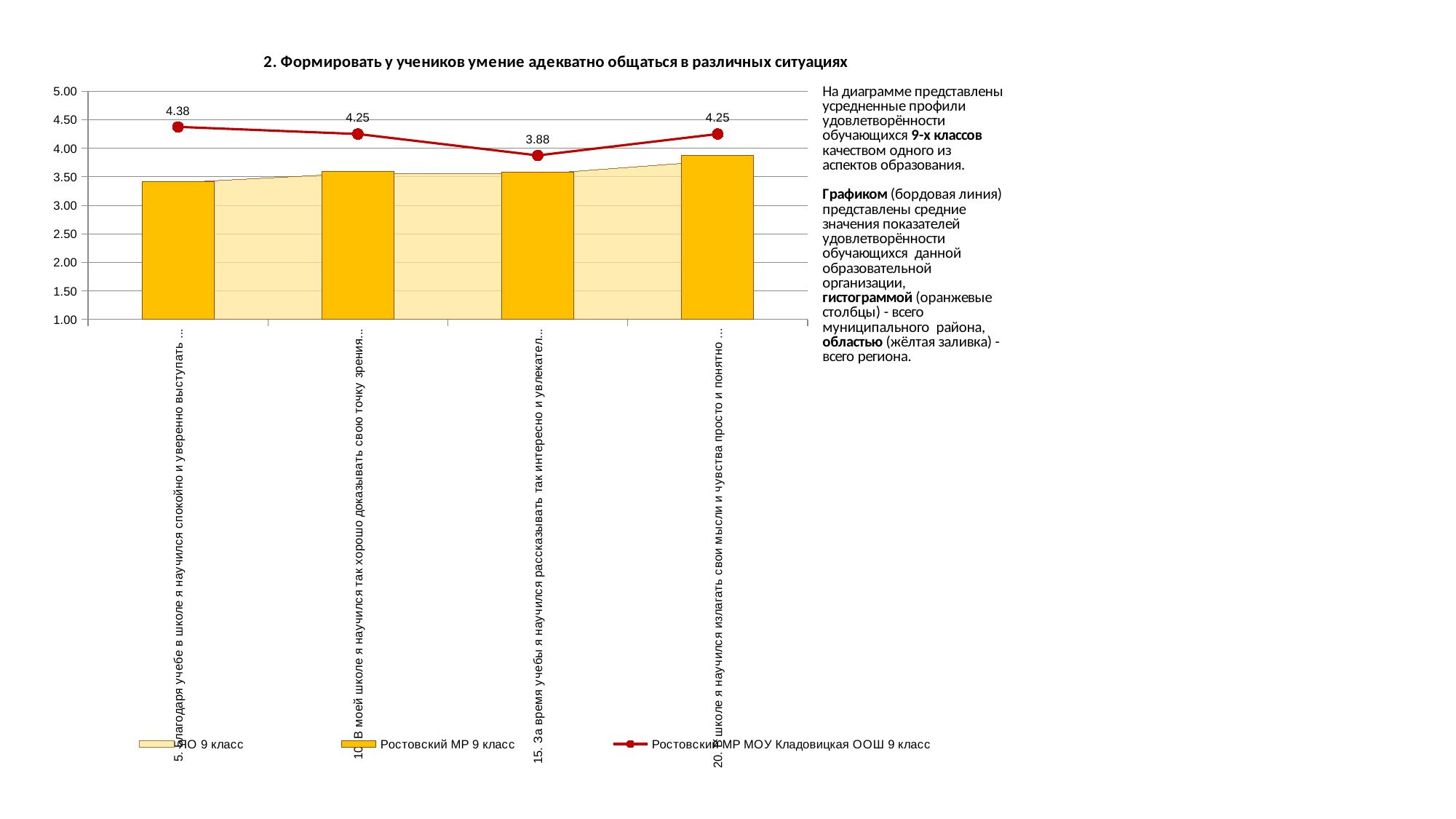
What is the value of the Ростовский МР МОУ Кладовицкая ООШ 9 класс line for category 15 (За время учебы я научился рассказывать так интересно и увлекательно...)? 3.88 What is the value of the Ростовский МР МОУ Кладовицкая ООШ 9 класс line for category 20 (В школе я научился излагать свои мысли и чувства просто и понятно...)? 4.25 How many series does the chart legend list? 3 For which category is the Ростовский МР МОУ Кладовицкая ООШ 9 класс line highest? 5. Благодаря учебе в школе я научился спокойно и уверенно выступать... Which is larger for the Ростовский МР МОУ Кладовицкая ООШ 9 класс line: the value for category 10 or for category 15? Category 10 Does the Ростовский МР МОУ Кладовицкая ООШ 9 класс line rise or fall from category 10 to category 15? fall How many categories are shown on the x axis of the chart? 4 What is the value of the Ростовский МР МОУ Кладовицкая ООШ 9 класс line for category 5 (Благодаря учебе в школе я научился спокойно и уверенно выступать...)? 4.38 What is the difference between the highest and lowest values of the Ростовский МР МОУ Кладовицкая ООШ 9 класс line? 0.50 Is the Ростовский МР 9 класс bar for category 20 greater or less than 4.00? less Is the Ростовский МР 9 класс bar for category 5 greater or less than 3.00? greater For which category is the Ростовский МР МОУ Кладовицкая ООШ 9 класс line lowest? 15. За время учебы я научился рассказывать так интересно и увлекательно...